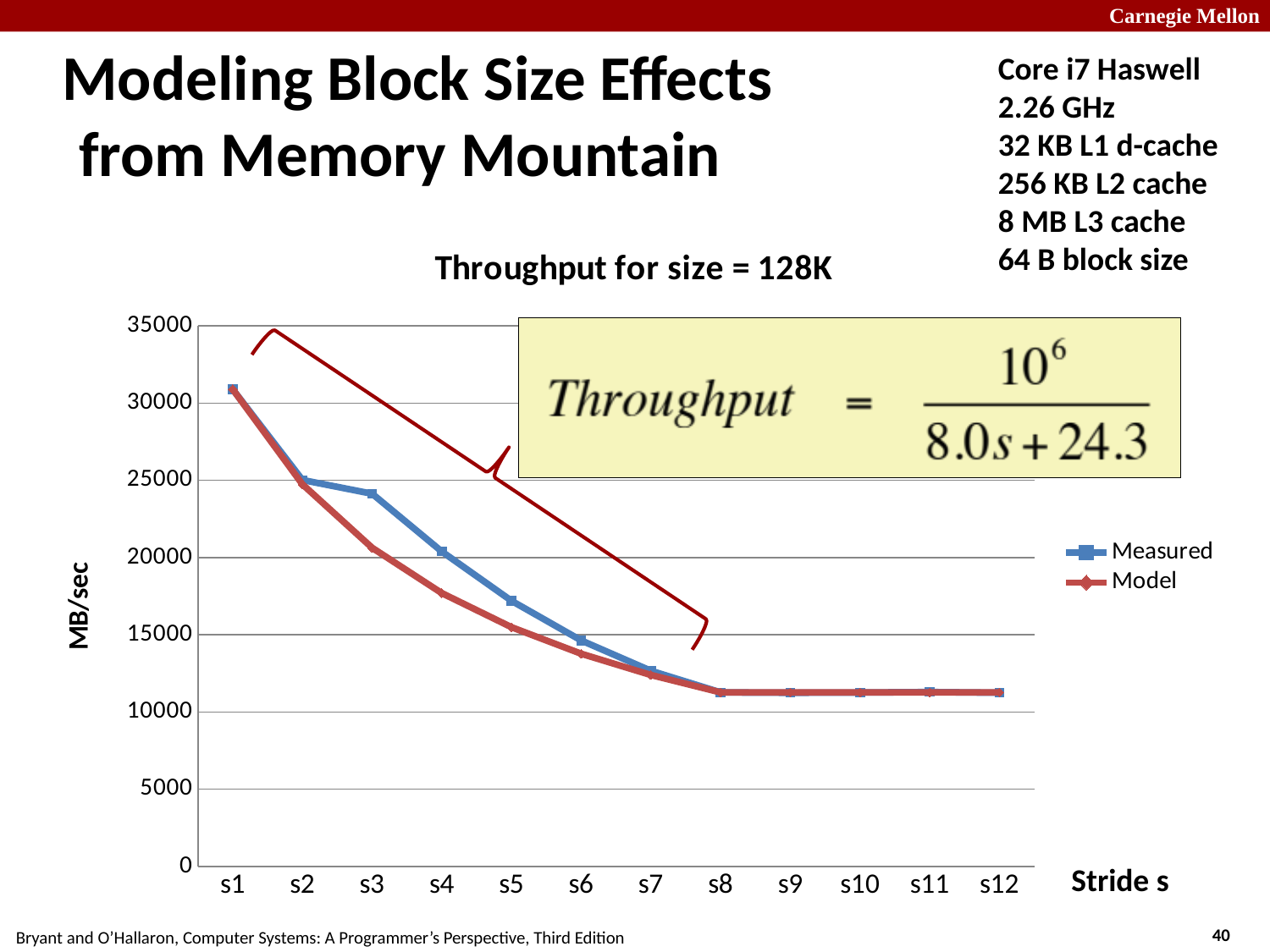
What kind of chart is shown on the slide? line chart How many stride values are plotted along the x axis? 12 At stride s3, which series has the larger value, Measured or Model? Measured Is the Model value at s8 greater or less than 15000? less What is the title of the chart? Throughput for size = 128K What is the label on the chart's y axis? MB/sec How many series does the chart's legend list? 2 Is the Measured value at s3 greater or less than 20000? greater Do the Measured values rise or fall as the stride increases from s1 to s8? fall Is the Measured value at s5 greater or less than 15000? greater At which stride is the Measured throughput highest? s1